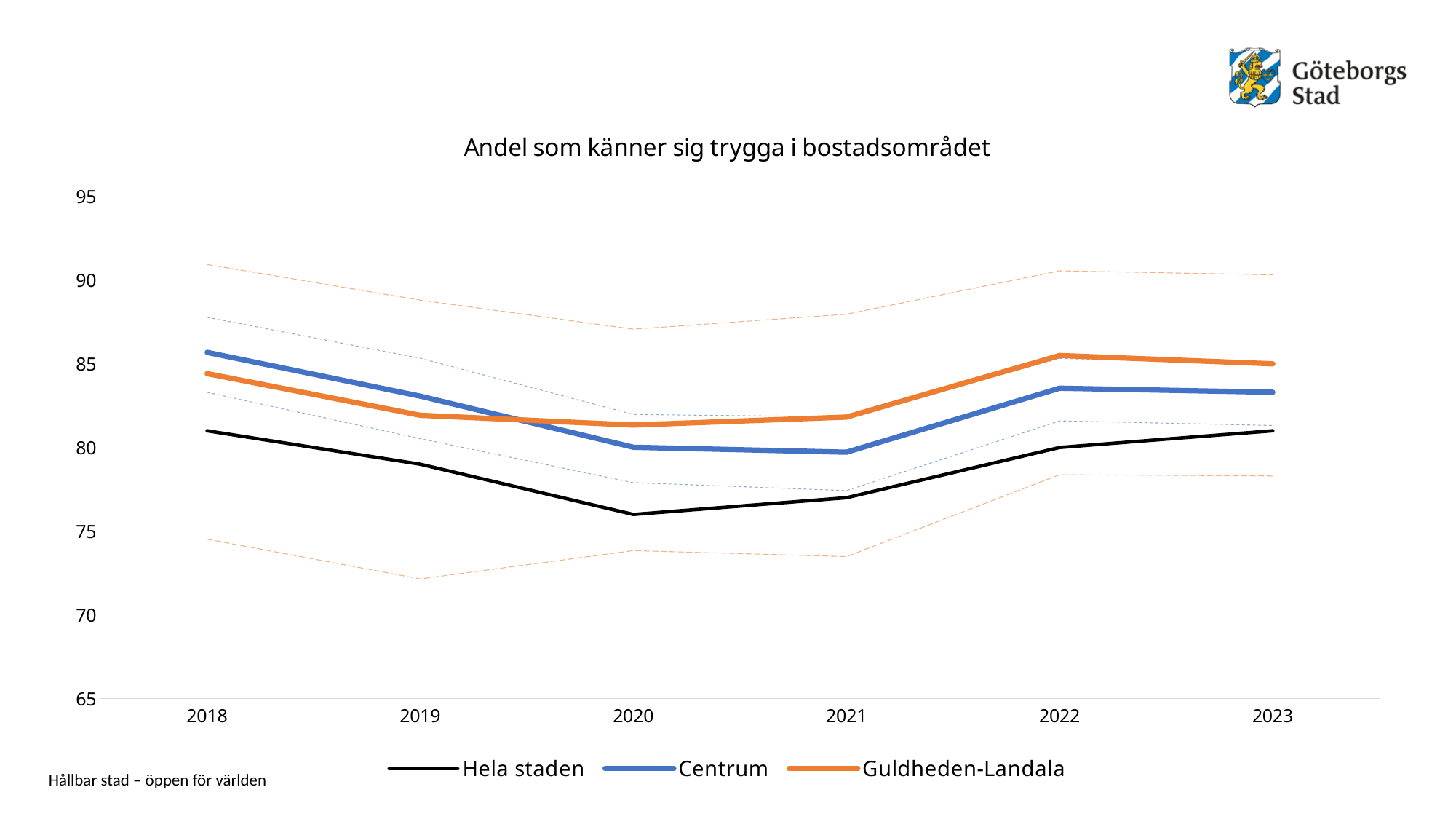
What is the title of the chart? Andel som känner sig trygga i bostadsområdet Is the value for Hela staden in 2020 greater or less than 80? less In 2023, which is higher: Centrum or Guldheden-Landala? Guldheden-Landala In 2018, which is higher: Centrum or Guldheden-Landala? Centrum Is the value for Centrum in 2018 greater or less than 85? greater How many years are shown on the x axis? 6 Is the value for Hela staden in 2023 greater or less than 80? greater In which year is the value for Hela staden lowest? 2020 What kind of chart is shown on the slide? line chart How many series does the legend list? 3 In which year is the value for Centrum highest? 2018 Does the value for Hela staden rise or fall from 2021 to 2023? rise